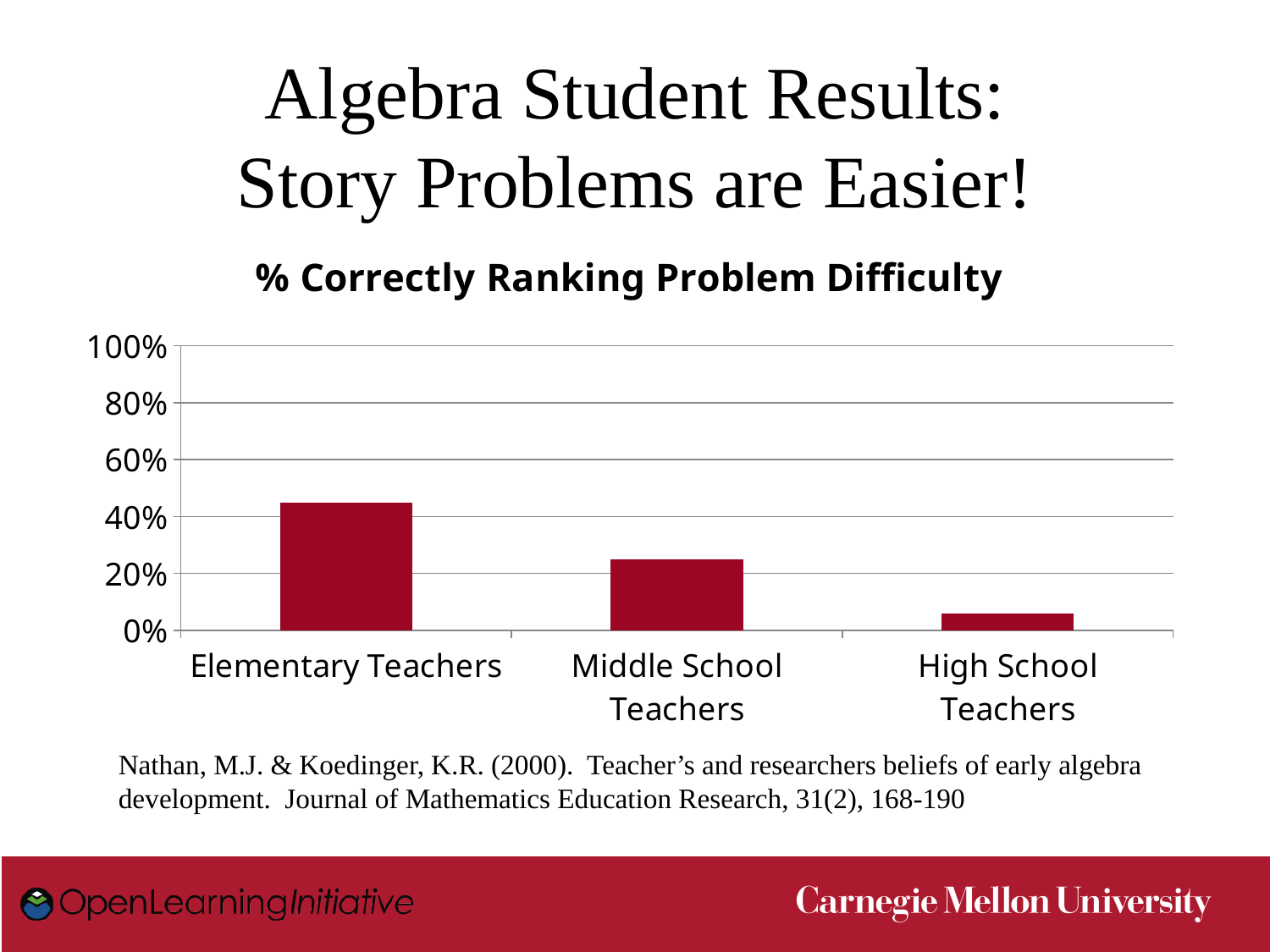
Is the value for High School Teachers greater or less than 20%? less Is the value for Middle School Teachers greater or less than 20%? greater Is the value for Elementary Teachers greater or less than 60%? less Which category has the highest value in the chart? Elementary Teachers What is the title of the chart? % Correctly Ranking Problem Difficulty Which is larger, the value for Middle School Teachers or the value for High School Teachers? Middle School Teachers Do the values rise or fall moving from left to right along the x axis? fall How many categories are shown on the x axis of the chart? 3 Which category has the lowest value in the chart? High School Teachers What kind of chart is shown on the slide? bar chart